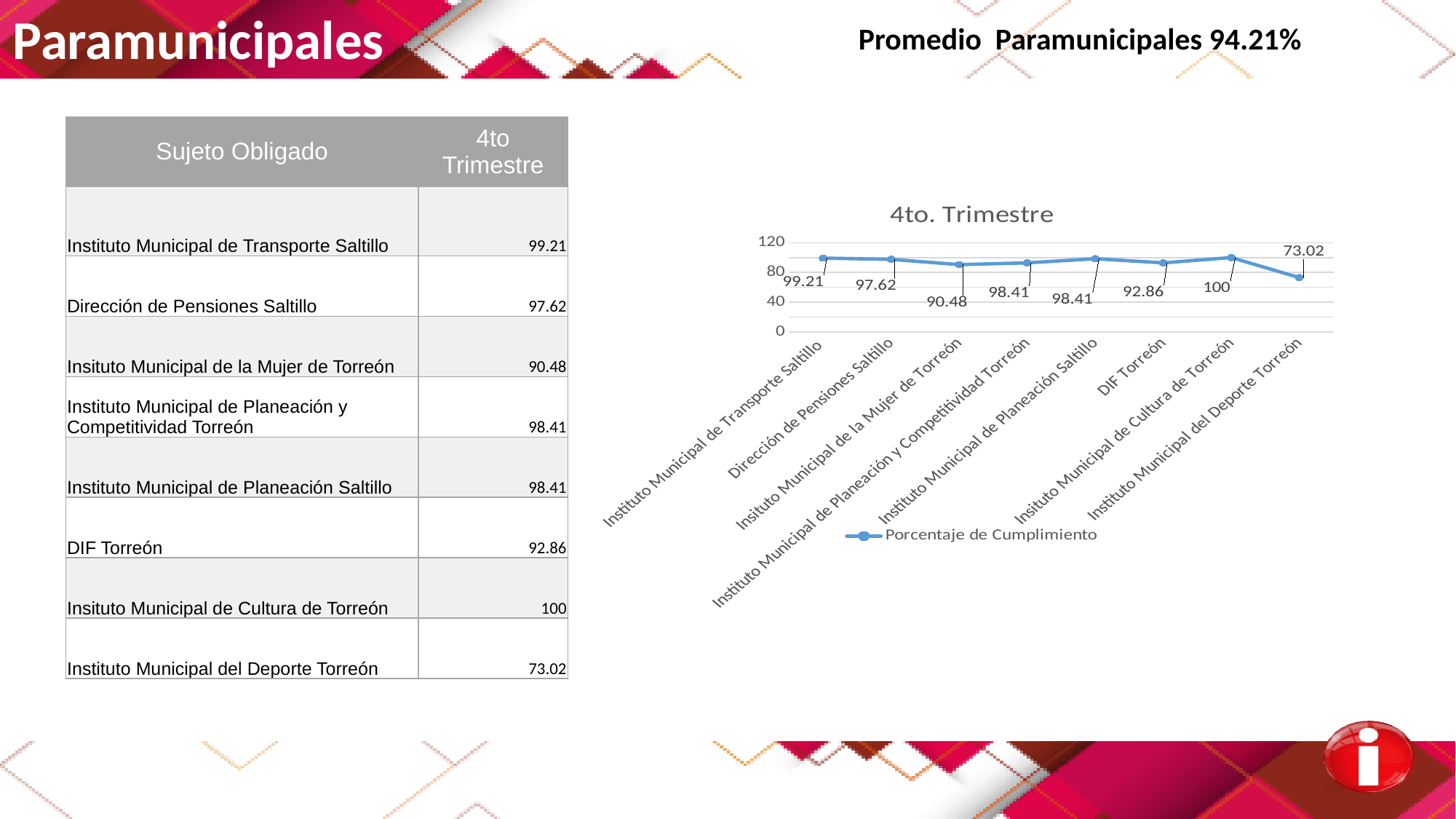
What is the value for Instituto Municipal del Deporte Torreón in the chart? 73.02 Which category has the lowest value in the chart? Instituto Municipal del Deporte Torreón How many series does the chart legend list? 1 What kind of chart is shown on the slide? line chart What is the difference between the values for Insituto Municipal de Cultura de Torreón and Instituto Municipal del Deporte Torreón? 26.98 What is the title of the chart? 4to. Trimestre Is the value for Instituto Municipal del Deporte Torreón greater or less than 80? less How many categories are plotted in the chart? 8 Which category has the highest value in the chart? Insituto Municipal de Cultura de Torreón What is the value for Instituto Municipal de Transporte Saltillo in the chart? 99.21 Which is larger: the value for Dirección de Pensiones Saltillo or the value for Insituto Municipal de la Mujer de Torreón? Dirección de Pensiones Saltillo What is the value for DIF Torreón in the chart? 92.86